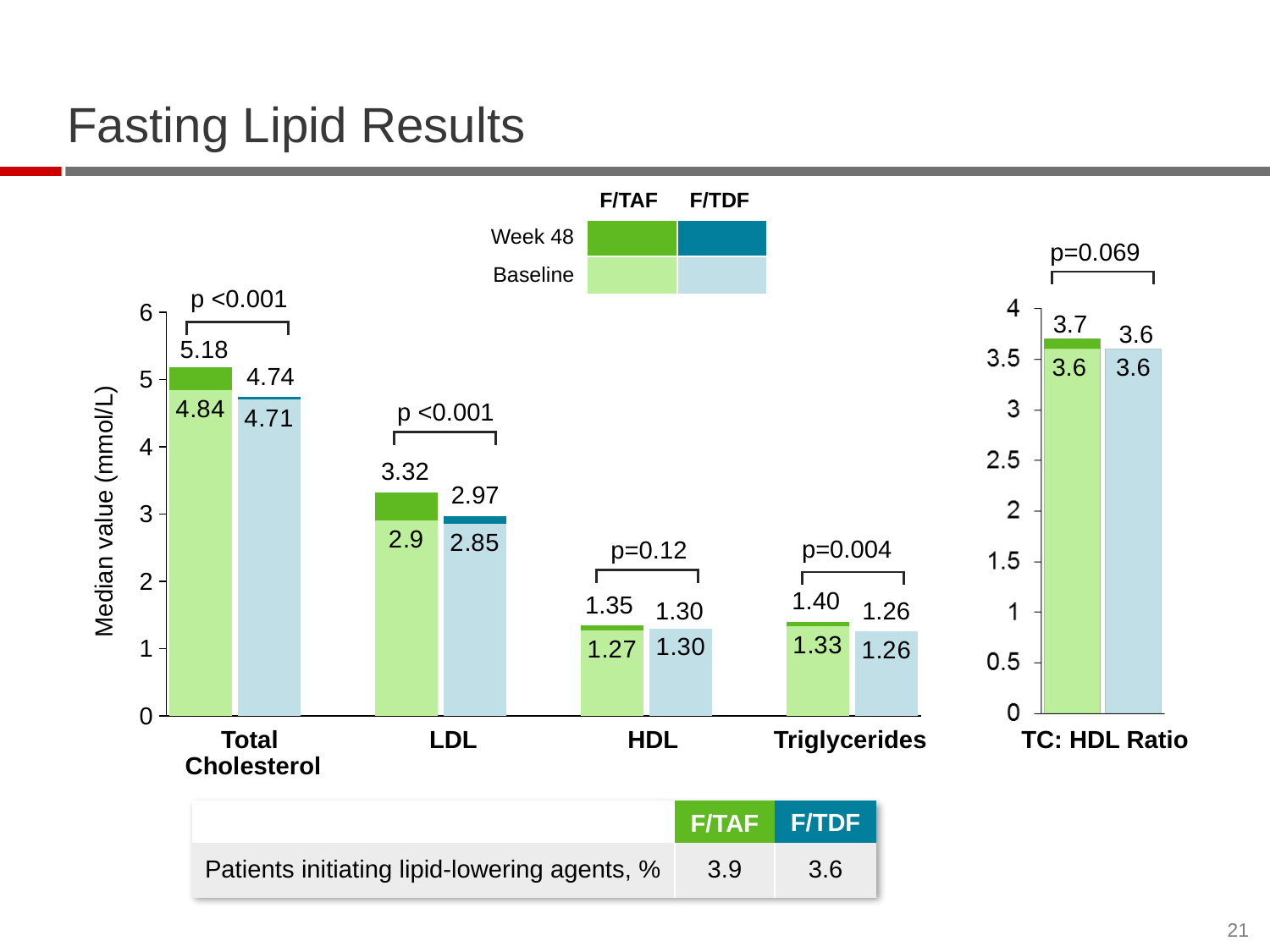
In the main lipid chart, what is the F/TAF Week 48 median value for Total Cholesterol? 5.18 In the main lipid chart, which category has the lowest F/TDF Week 48 median value? Triglycerides What kind of chart is the TC: HDL Ratio chart? bar chart In the main lipid chart, what is the difference between the F/TAF and F/TDF Week 48 median values for Total Cholesterol? 0.44 In the main lipid chart, which category has the highest F/TAF Week 48 median value? Total Cholesterol What p-value is shown above the HDL bars in the main lipid chart? p=0.12 In the main lipid chart, is the F/TAF Week 48 value for Total Cholesterol greater or less than 5? greater In the main lipid chart, which is larger for HDL at Week 48: the F/TAF value or the F/TDF value? F/TAF In the TC: HDL Ratio chart, what is the F/TAF Week 48 value? 3.7 In the main lipid chart, what is the F/TAF Week 48 median value for Triglycerides? 1.40 In the main lipid chart, what is the F/TDF baseline median value for LDL? 2.85 How many lipid categories are shown on the x axis of the main lipid chart? 4